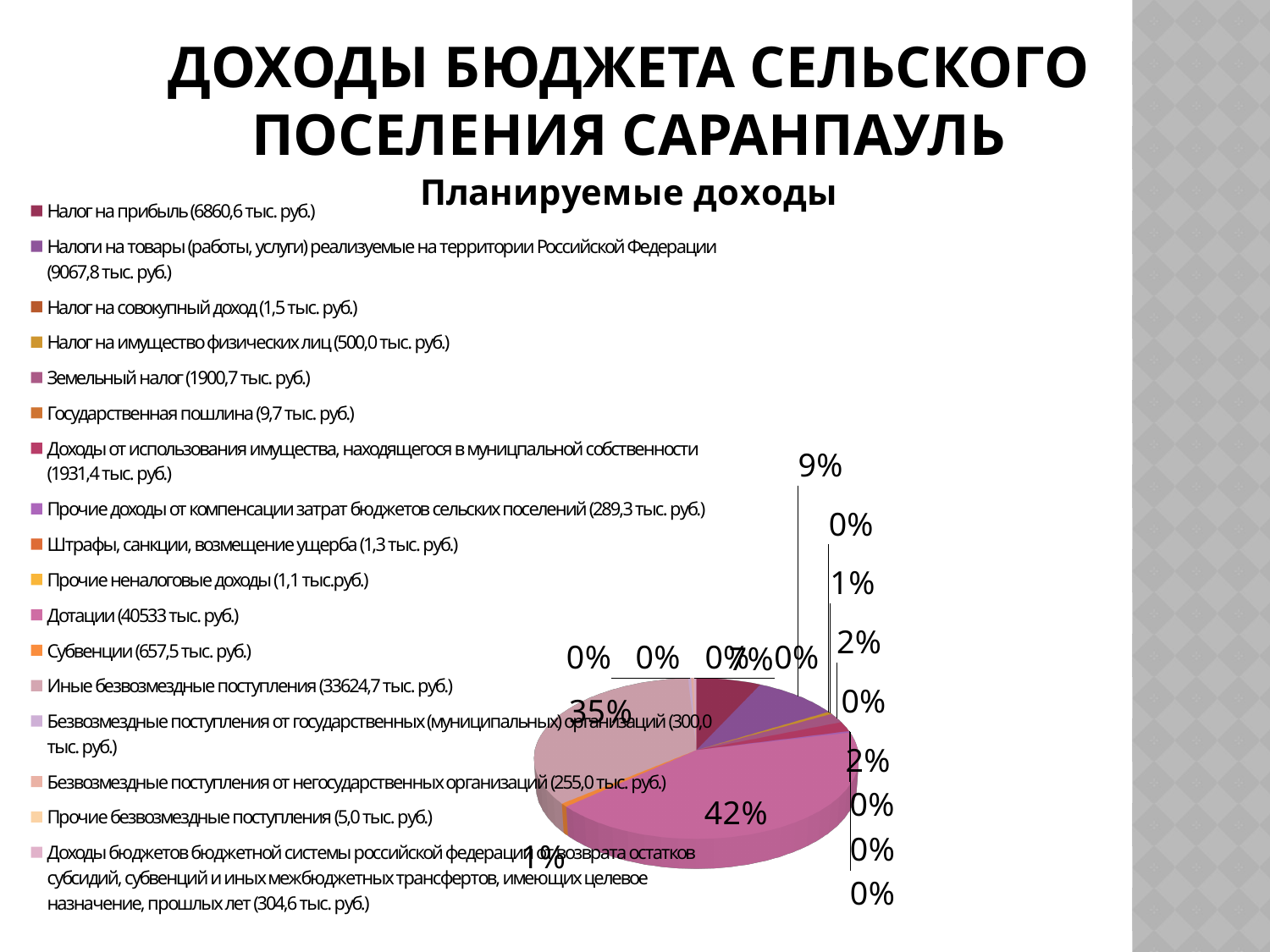
What amount does the legend give for Налог на прибыль? 6860,6 тыс. руб. What is the title of the chart? Планируемые доходы What amount does the legend give for Дотации? 40533 тыс. руб. What amount does the legend give for Субвенции? 657,5 тыс. руб. What share of the pie does Дотации take? 42% What share of the pie does Иные безвозмездные поступления take? 35% What amount does the legend give for Иные безвозмездные поступления? 33624,7 тыс. руб. Which slice is larger: Дотации or Иные безвозмездные поступления? Дотации What kind of chart is shown on the slide? pie chart How many categories does the chart's legend list? 17 By how many percentage points does the Дотации share exceed the Иные безвозмездные поступления share? 7 Which category has the largest slice of the pie? Дотации